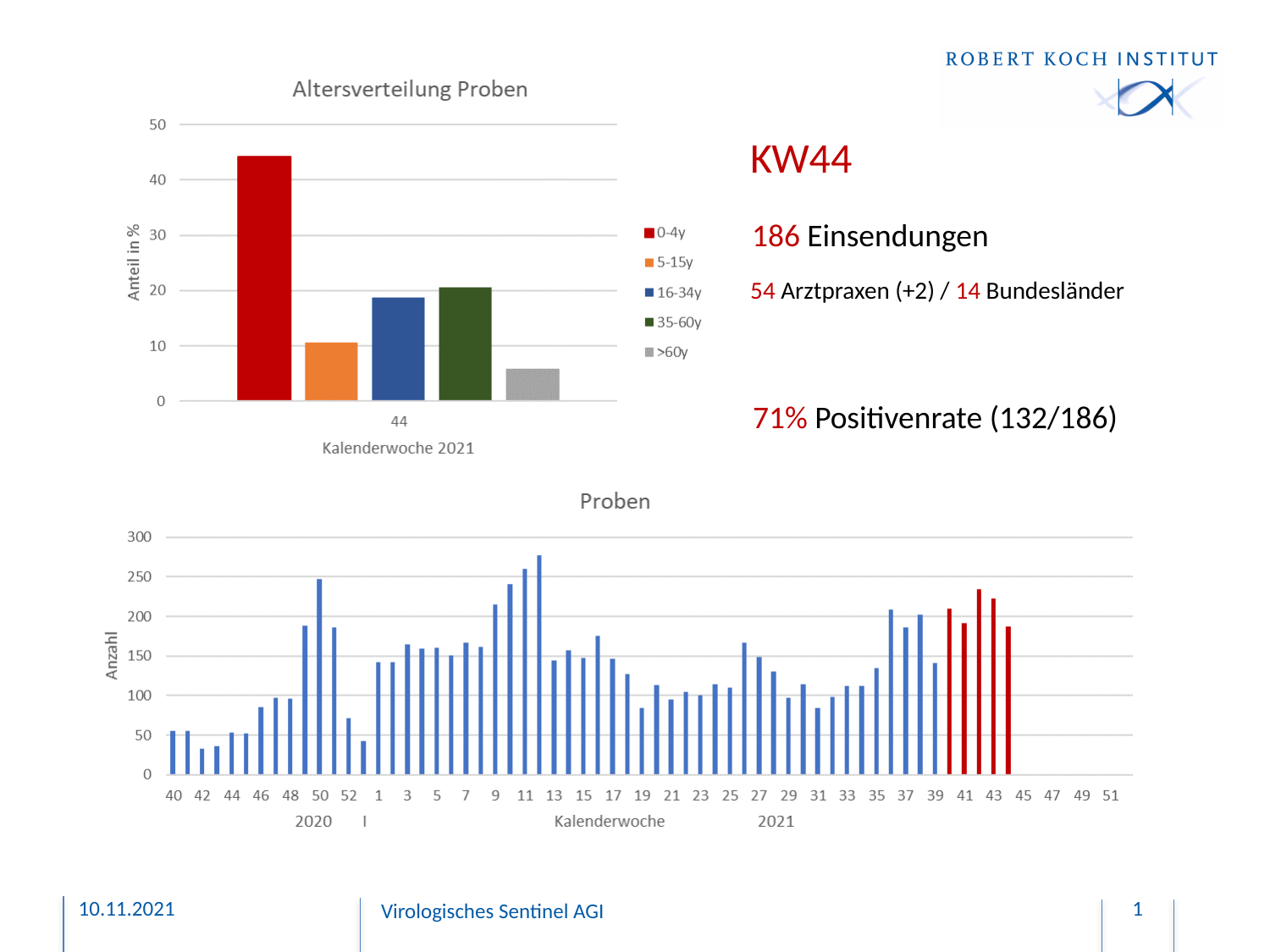
In the 'Proben' chart, is the value for calendar week 50 of 2020 greater or less than 200? greater In the 'Proben' chart, do the values rise or fall from calendar week 40 to calendar week 50 of 2020? rise In the 'Altersverteilung Proben' chart, which is larger, the value for 0-4y or the value for 5-15y? 0-4y What is the y-axis label of the 'Proben' chart at the bottom of the slide? Anzahl In the 'Altersverteilung Proben' chart, which age group has the highest share? 0-4y What kind of chart is the 'Altersverteilung Proben' chart? bar chart How many series does the legend of the 'Altersverteilung Proben' chart list? 5 In the 'Altersverteilung Proben' chart, is the value for >60y greater or less than 10? less In the 'Altersverteilung Proben' chart, is the value for 0-4y greater or less than 40? greater In the 'Altersverteilung Proben' chart, which age group has the lowest share? >60y In the 'Proben' chart, how many bars are coloured red? 5